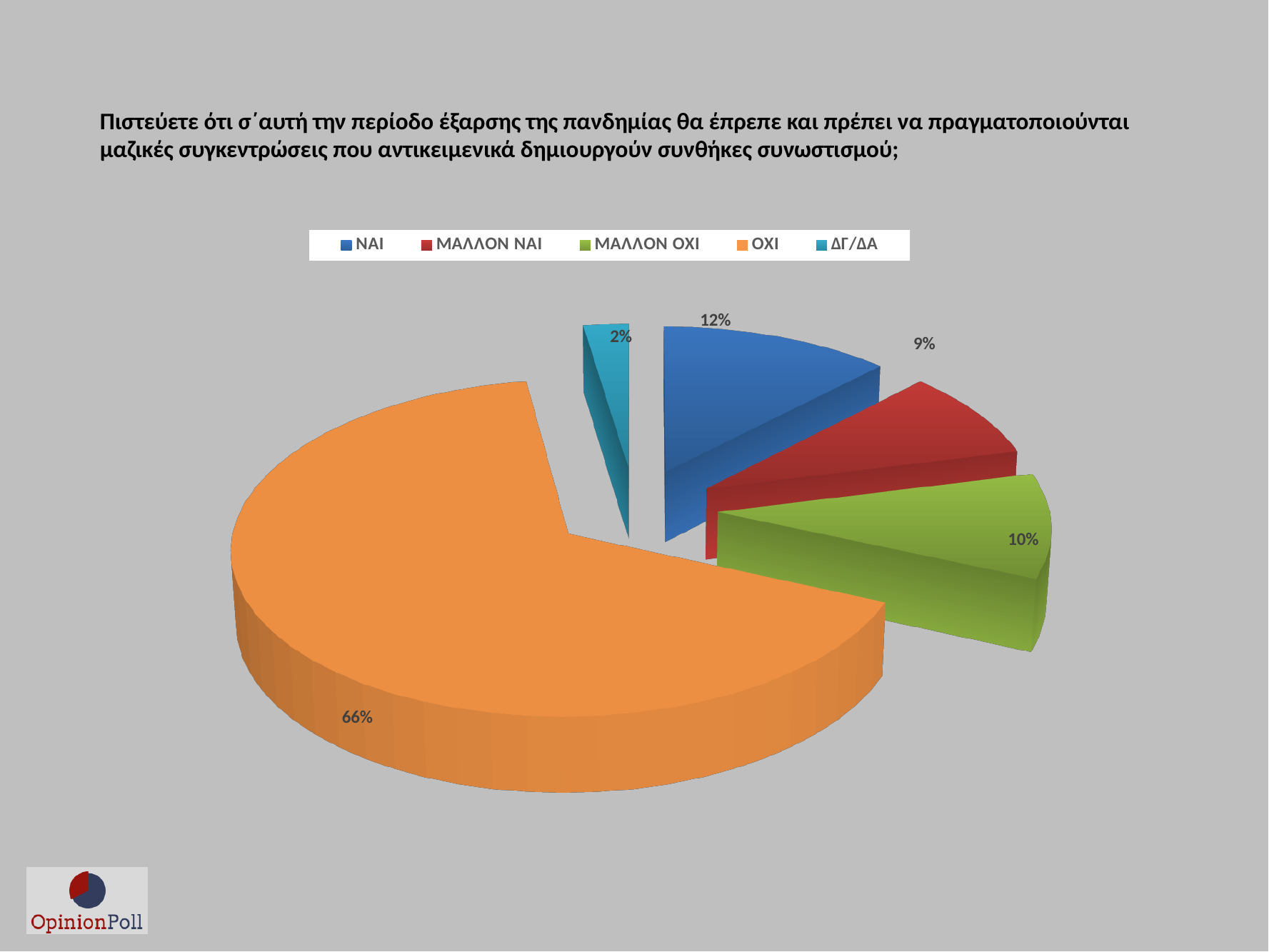
What percentage of respondents answered ΟΧΙ? 66% Which response has the largest share of the pie? ΟΧΙ What percentage of respondents answered ΝΑΙ? 12% How many categories does the pie chart show? 5 Which response has the smallest share of the pie? ΔΓ/ΔΑ What is the difference in percentage points between ΟΧΙ and ΝΑΙ? 54 What percentage of respondents answered ΜΑΛΛΟΝ ΝΑΙ? 9% What percentage of respondents answered ΜΑΛΛΟΝ ΟΧΙ? 10% What colour is the slice for ΟΧΙ? Orange What percentage of respondents answered ΔΓ/ΔΑ? 2% Which is larger, the share for ΝΑΙ or the share for ΜΑΛΛΟΝ ΝΑΙ? ΝΑΙ What kind of chart is shown on the slide? Pie chart